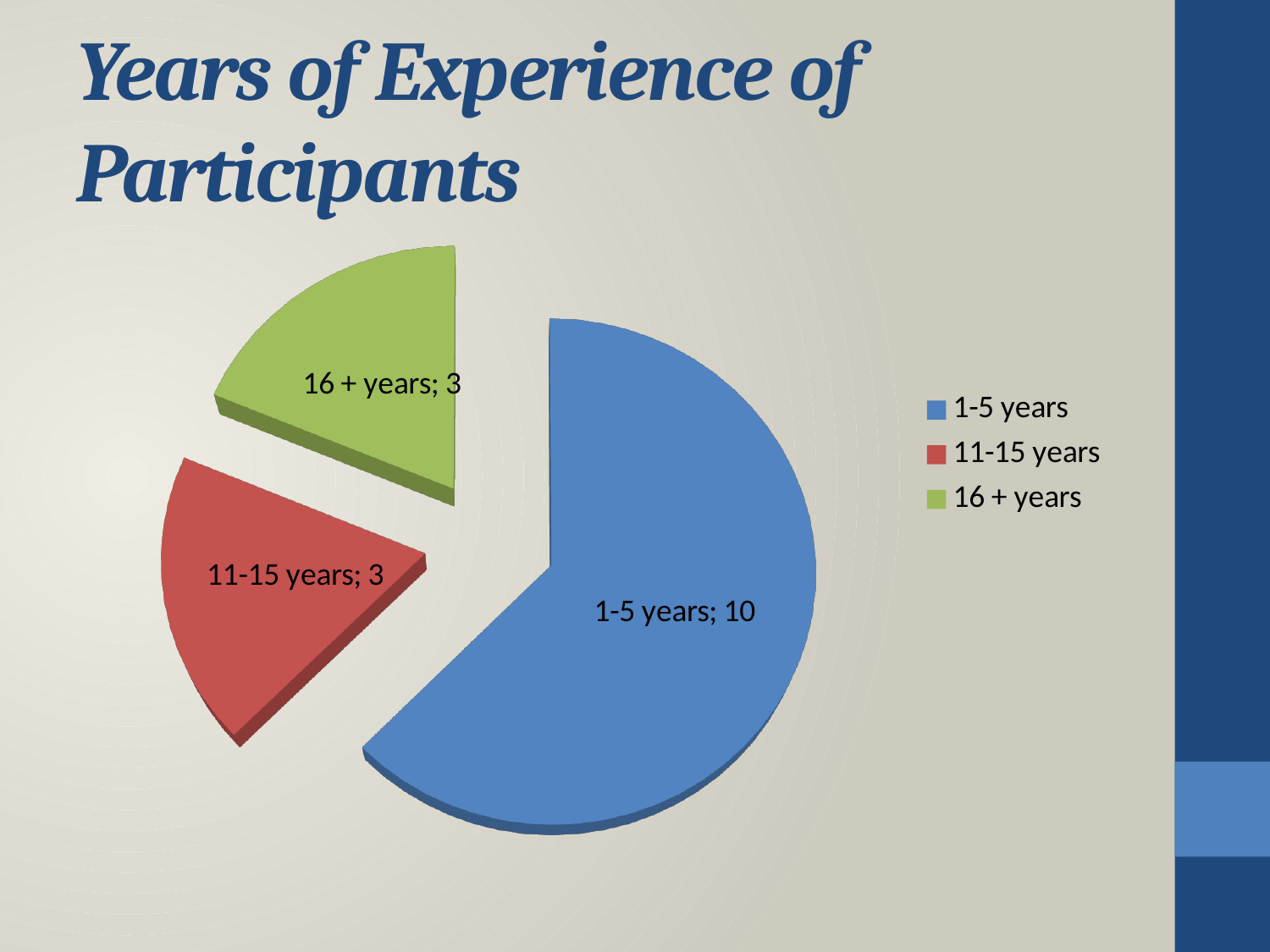
What type of chart is shown on the slide? Pie chart What is the value for the 1-5 years slice? 10 Which category has the largest slice of the pie? 1-5 years Which is larger, the value for 1-5 years or the value for 16 + years? 1-5 years What share of the pie does the 1-5 years slice represent? 62.5% What is the value for the 11-15 years slice? 3 How many slices does the pie chart have? 3 What is the value for the 16 + years slice? 3 Do the 11-15 years and 16 + years slices have the same value? Yes What is the title of the slide containing the chart? Years of Experience of Participants What is the total of all the slices in the pie chart? 16 What is the difference between the values for 1-5 years and 11-15 years? 7